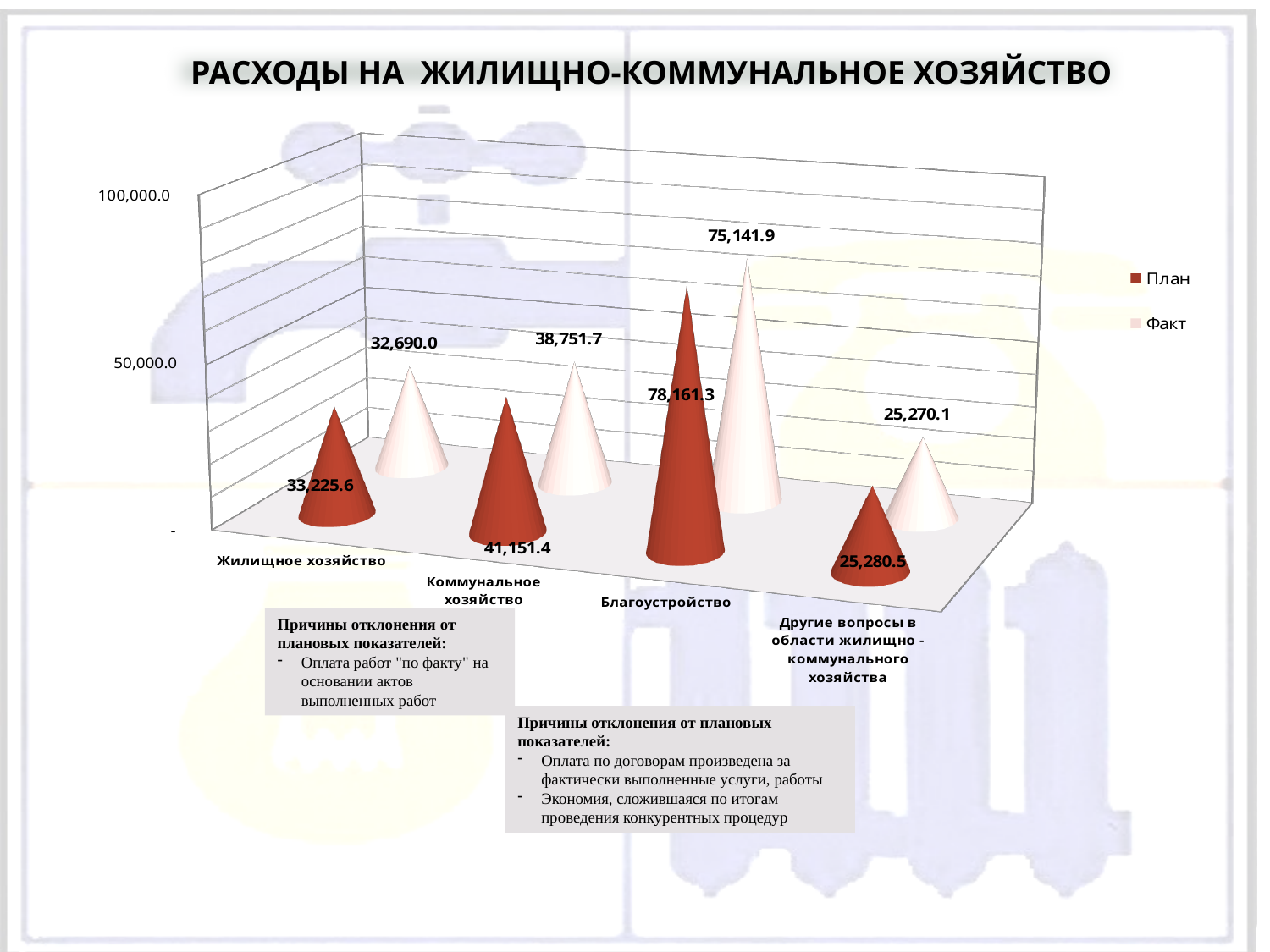
Which category has the highest План value? Благоустройство What is the difference between the План and Факт values for Благоустройство? 3,019.4 What is the План value for Благоустройство? 78,161.3 What is the difference between the План and Факт values for Коммунальное хозяйство? 2,399.7 What is the План value for Другие вопросы в области жилищно-коммунального хозяйства? 25,280.5 Which is larger for Коммунальное хозяйство, the План value or the Факт value? План How many series does the legend list? 2 Is the Факт value for Жилищное хозяйство greater or less than 50,000.0? less How many categories are shown on the x axis? 4 What is the Факт value for Коммунальное хозяйство? 38,751.7 What is the Факт value for Жилищное хозяйство? 32,690.0 Which category has the lowest Факт value? Другие вопросы в области жилищно-коммунального хозяйства